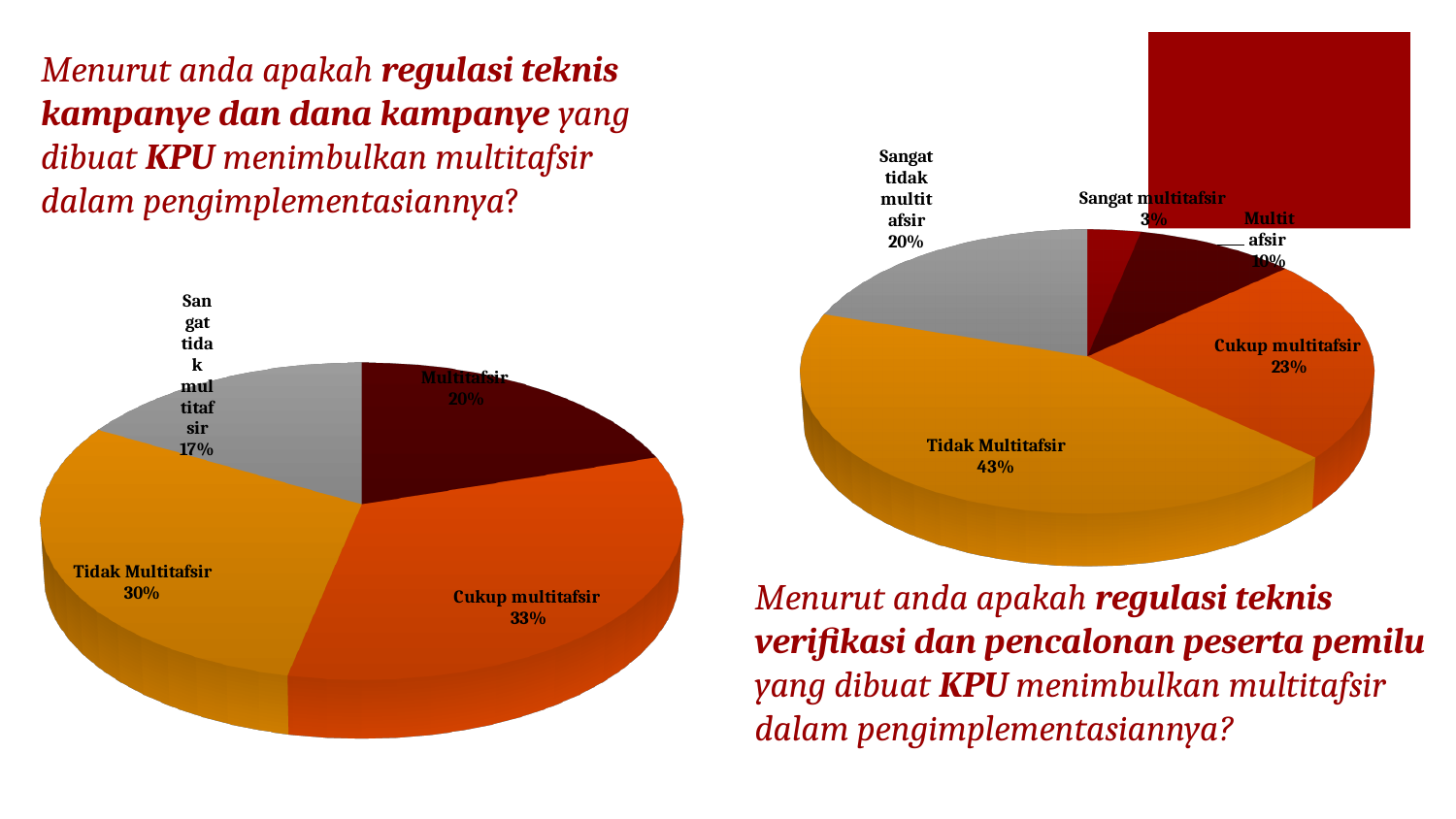
On the right pie chart, which is larger, Cukup multitafsir or Sangat tidak multitafsir? Cukup multitafsir On the right pie chart, what percentage is shown for Tidak Multitafsir? 43% How many slices does the right pie chart have? 5 On the left pie chart, what percentage is shown for Tidak Multitafsir? 30% On the left pie chart, which category has the smallest share? Sangat tidak multitafsir On the left pie chart, which category has the largest share? Cukup multitafsir On the left pie chart, what percentage is shown for Sangat tidak multitafsir? 17% On the right pie chart, what percentage is shown for Sangat multitafsir? 3% On the left pie chart, what percentage is shown for Cukup multitafsir? 33% On the left pie chart, what is the difference between Cukup multitafsir and Multitafsir? 13% What type of chart is the left chart? Pie chart On the right pie chart, which category has the largest share? Tidak Multitafsir